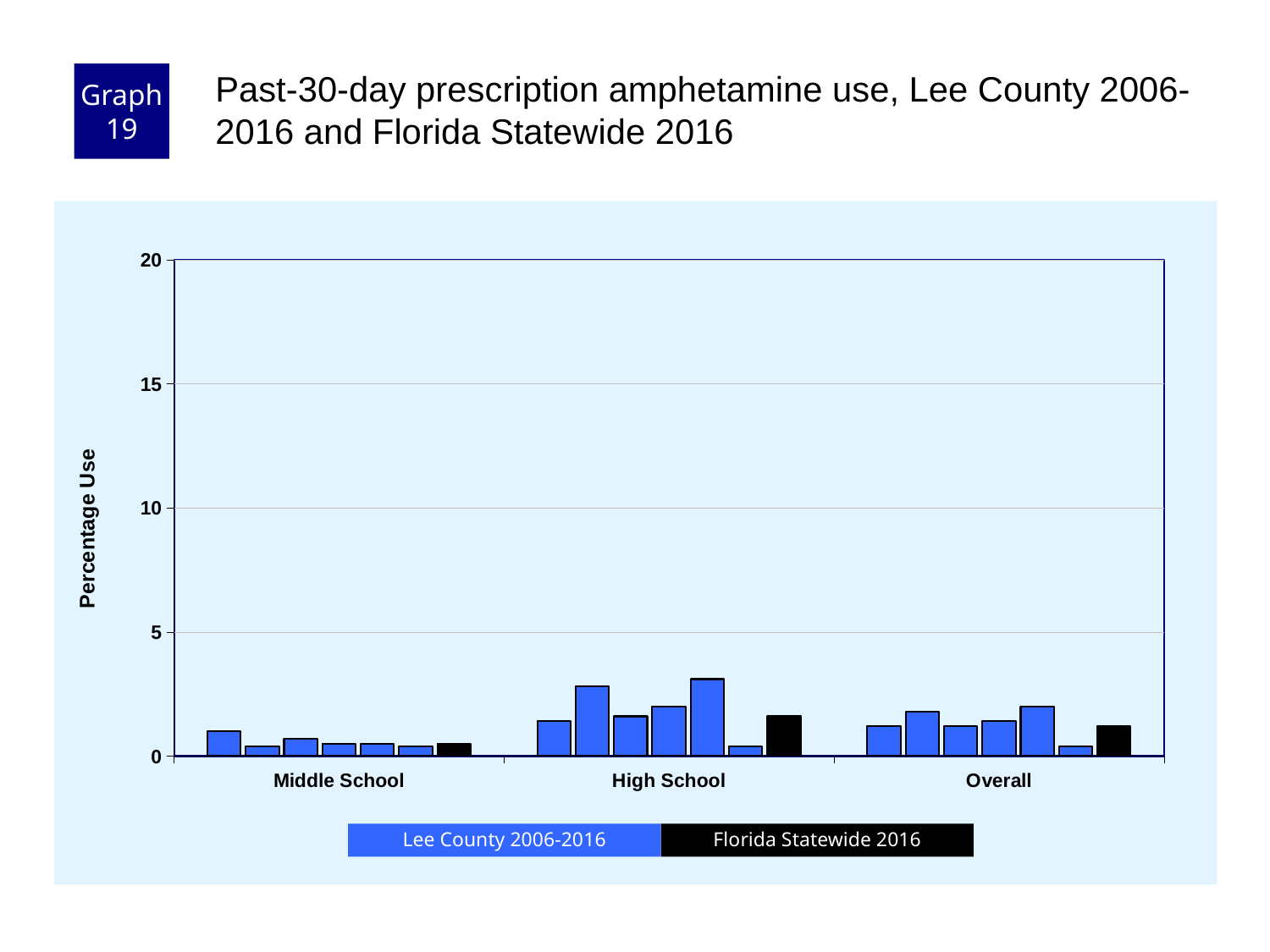
Is the Florida Statewide 2016 value for Middle School greater or less than 5? less How many school-level categories are shown on the x axis? 3 In which category is the Florida Statewide 2016 value highest? High School In which category is the Florida Statewide 2016 value lowest? Middle School What is the label on the y axis? Percentage Use Is the Florida Statewide 2016 value for High School greater or less than 5? less Which category contains the tallest bar on the chart? High School What kind of chart is shown on the slide? bar chart Is the tallest Lee County 2006-2016 bar in the High School group greater or less than 5? less How many series does the legend list? 2 Which series is drawn in black? Florida Statewide 2016 Which is larger: the Florida Statewide 2016 value for High School or for Middle School? High School